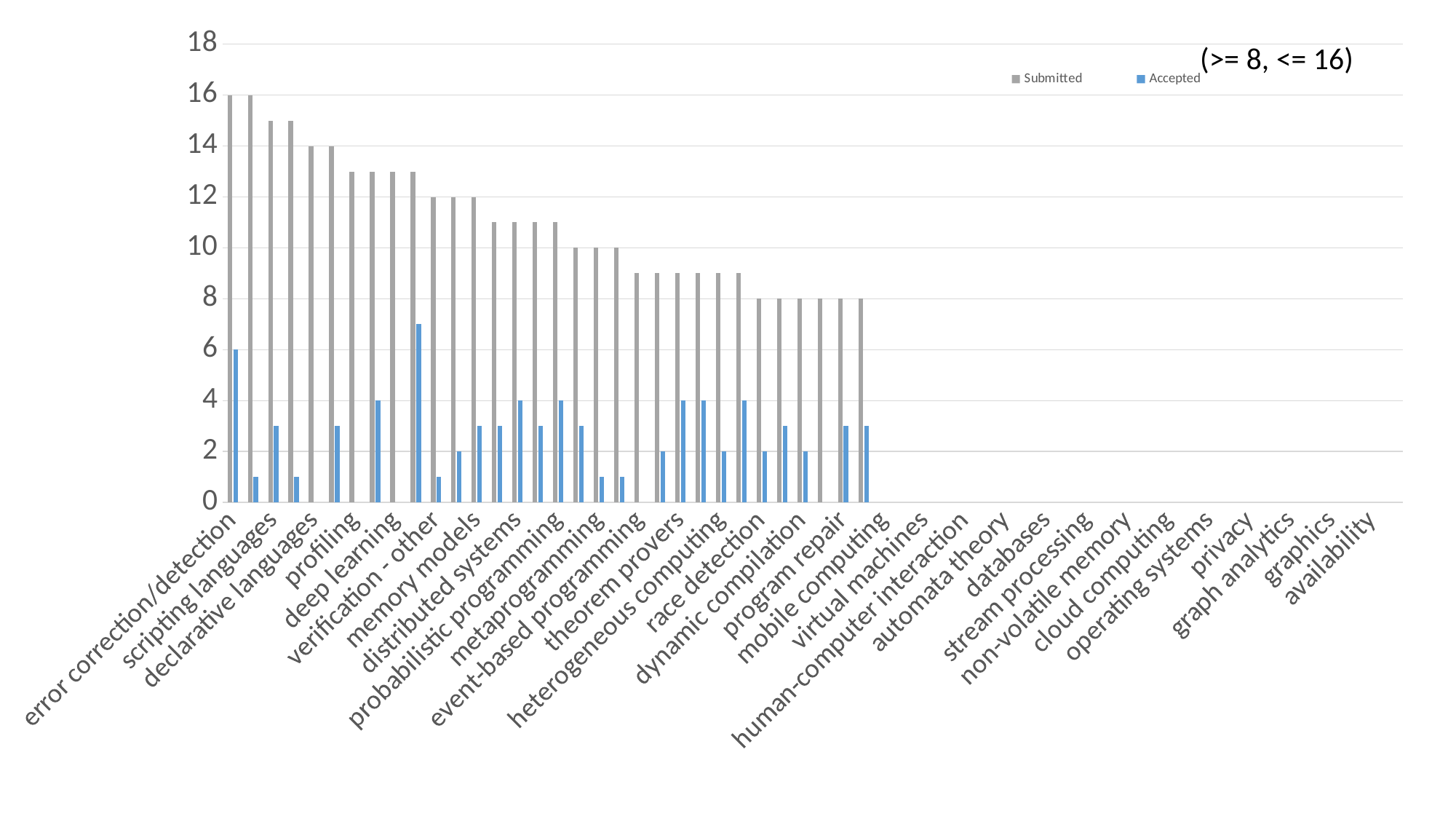
Do the Submitted bars rise or fall from left to right along the x axis? fall For the leftmost category, which is larger, Submitted or Accepted? Submitted What are the two series named in the legend? Submitted and Accepted What is the Accepted value for the leftmost category? 6 What is the highest Submitted value shown in the chart? 16 Is the tallest Accepted bar greater or less than 6? greater What is the Submitted value for the leftmost category? 16 For the leftmost category, what is the difference between the Submitted and Accepted values? 10 What kind of chart is shown on the slide? bar chart What is the lowest Submitted value shown in the chart? 8 What text annotation appears in the top right of the chart? (>= 8, <= 16) How many series does the legend list? 2